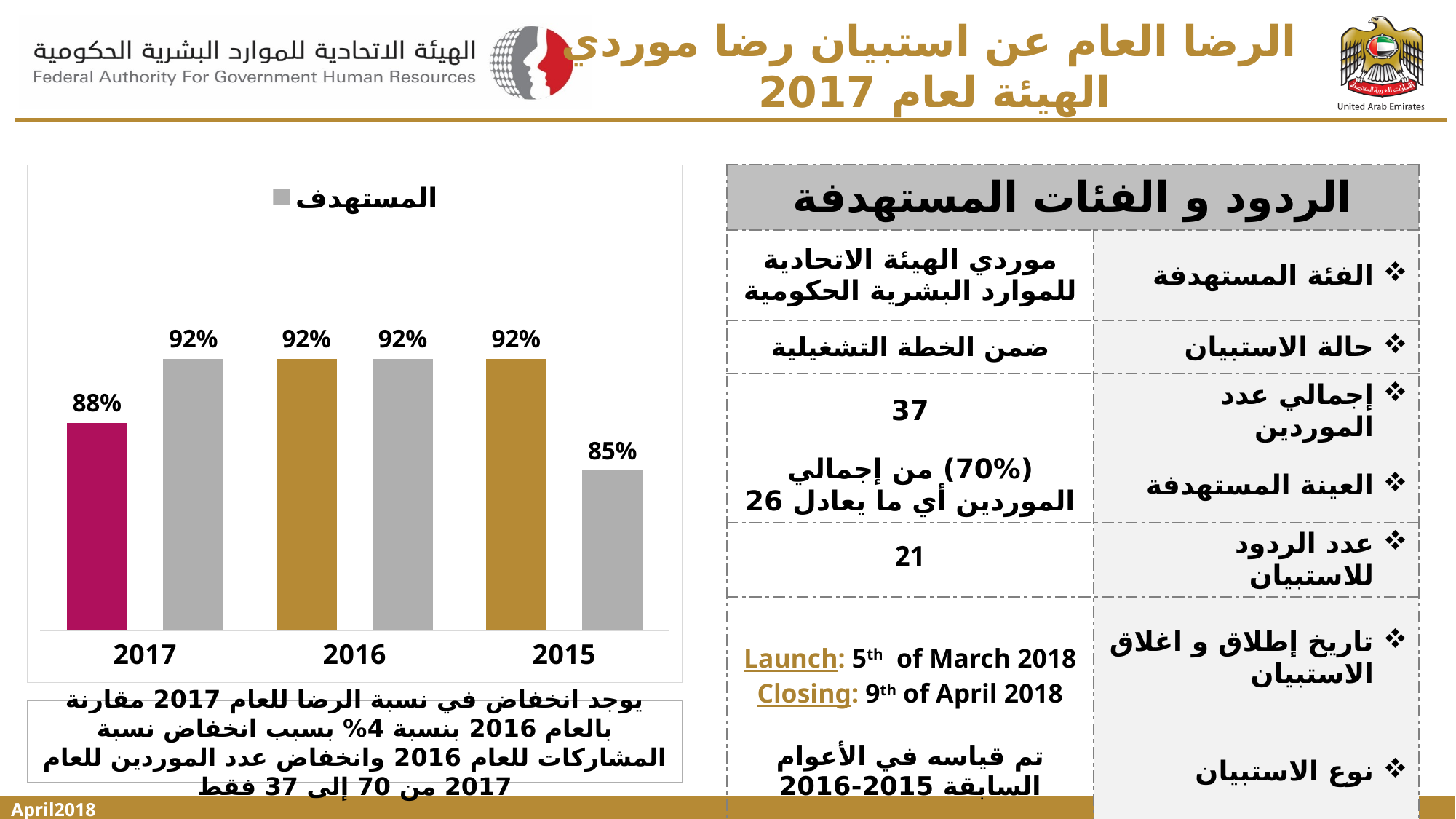
For 2017, which is larger: the magenta bar or the gray bar? the gray bar What is the difference between the gray bar and the magenta bar for 2017? 4% What is the value of the gray bar for 2017? 92% What is the legend entry shown above the bar chart? المستهدف Which bar has the lowest value in the chart? the gray bar for 2015 (85%) What kind of chart is shown on the left of the slide? bar chart What is the difference between the gold bar and the gray bar for 2015? 7% What is the value of the gold bar for 2016? 92% Do the gray bars rise or fall going from 2017 to 2015 along the x axis? fall How many years are shown on the x axis of the bar chart? 3 What is the value of the magenta bar for 2017? 88% What is the value of the gray bar for 2015? 85%